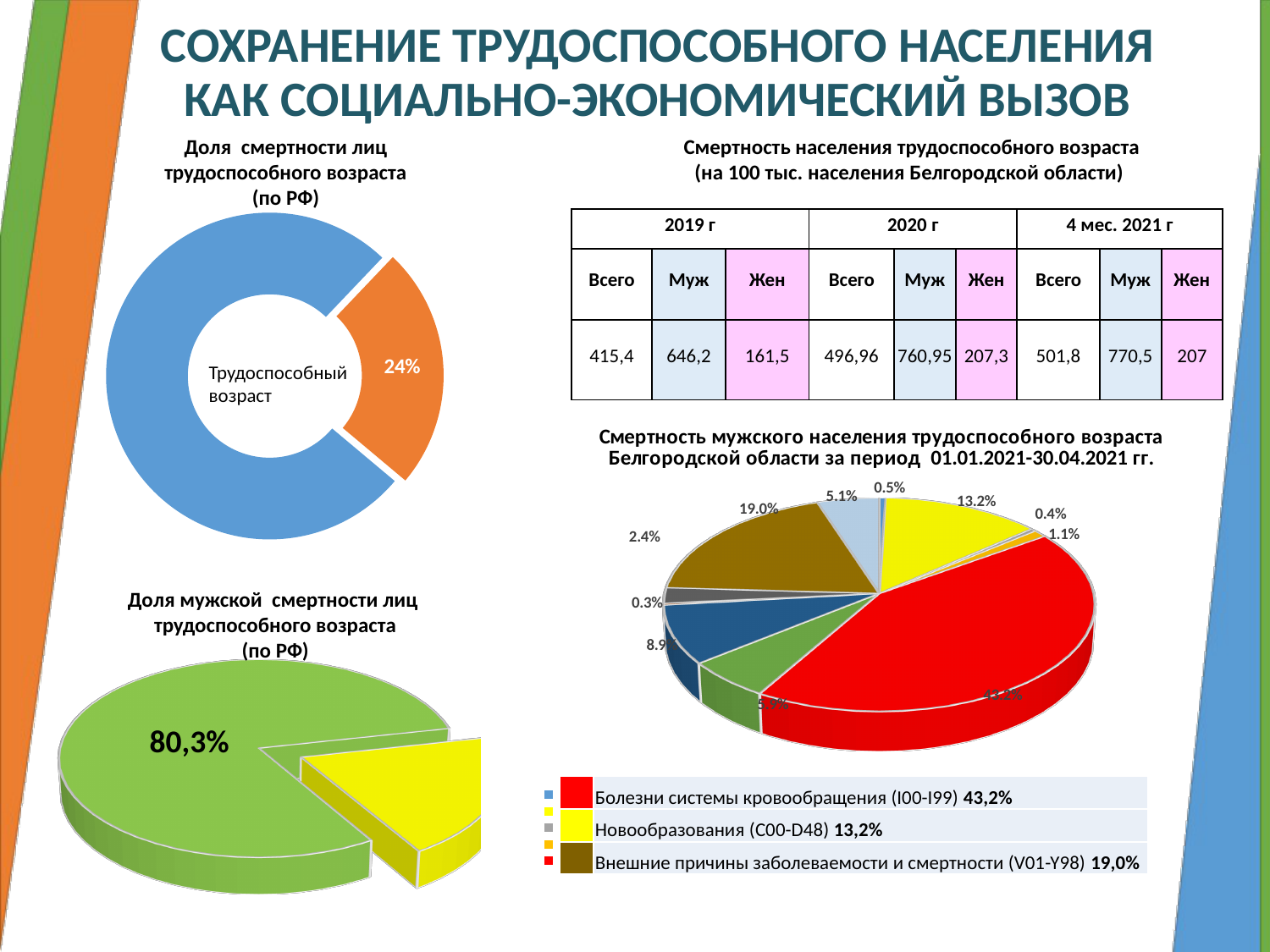
In the chart 'Смертность мужского населения трудоспособного возраста Белгородской области за период 01.01.2021-30.04.2021 гг.', what is the difference between the shares for 'Болезни системы кровообращения (I00-I99)' and 'Новообразования (C00-D48)'? 30,0% How many causes are listed with names in the legend of the chart 'Смертность мужского населения трудоспособного возраста Белгородской области за период 01.01.2021-30.04.2021 гг.'? 3 In the chart titled 'Доля мужской смертности лиц трудоспособного возраста (по РФ)', what value is printed on the green slice? 80,3% In the chart 'Смертность мужского населения трудоспособного возраста Белгородской области за период 01.01.2021-30.04.2021 гг.', what colour is the slice for 'Болезни системы кровообращения (I00-I99)'? Red In the chart 'Смертность мужского населения трудоспособного возраста Белгородской области за период 01.01.2021-30.04.2021 гг.', which is larger: the share for 'Новообразования (C00-D48)' or for 'Внешние причины заболеваемости и смертности (V01-Y98)'? Внешние причины заболеваемости и смертности (V01-Y98) What kind of chart is 'Доля смертности лиц трудоспособного возраста (по РФ)'? Donut (pie) chart In the chart titled 'Доля смертности лиц трудоспособного возраста (по РФ)', what percentage is shown for the orange slice? 24% In the chart titled 'Доля мужской смертности лиц трудоспособного возраста (по РФ)', which slice is larger, the green one or the yellow one? The green one In the chart 'Смертность мужского населения трудоспособного возраста Белгородской области за период 01.01.2021-30.04.2021 гг.', which cause has the largest share? Болезни системы кровообращения (I00-I99) In the chart 'Смертность мужского населения трудоспособного возраста Белгородской области за период 01.01.2021-30.04.2021 гг.', what share is shown for 'Болезни системы кровообращения (I00-I99)'? 43,2% In the chart 'Смертность мужского населения трудоспособного возраста Белгородской области за период 01.01.2021-30.04.2021 гг.', what share is shown for 'Внешние причины заболеваемости и смертности (V01-Y98)'? 19,0% In the chart 'Смертность мужского населения трудоспособного возраста Белгородской области за период 01.01.2021-30.04.2021 гг.', what share is shown for 'Новообразования (C00-D48)'? 13,2%